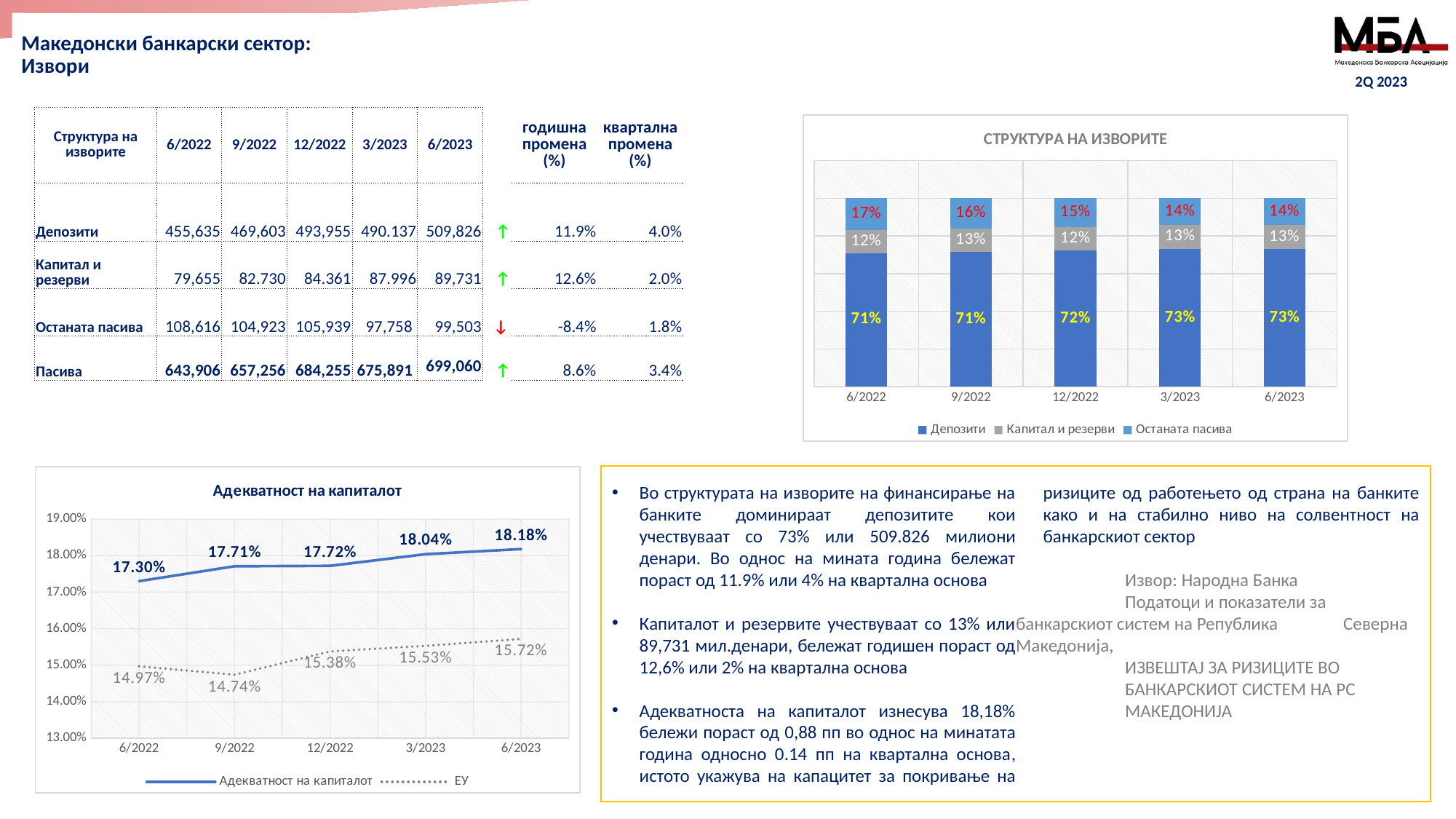
How many periods are shown on the x axis of the 'СТРУКТУРА НА ИЗВОРИТЕ' chart? 5 In the 'Адекватност на капиталот' chart, what is the value of Адекватност на капиталот in 6/2023? 18.18% In the 'Адекватност на капиталот' chart, which series has the larger value in 12/2022, Адекватност на капиталот or ЕУ? Адекватност на капиталот In the 'СТРУКТУРА НА ИЗВОРИТЕ' chart, what share does Останата пасива have in 6/2022? 17% In the 'Адекватност на капиталот' chart, what is the ЕУ value in 9/2022? 14.74% In the 'СТРУКТУРА НА ИЗВОРИТЕ' chart, what share do Депозити have in 6/2023? 73% What kind of chart is 'СТРУКТУРА НА ИЗВОРИТЕ'? stacked bar chart In the 'Адекватност на капиталот' chart, in which period is the ЕУ value lowest? 9/2022 How many series does the legend of the 'СТРУКТУРА НА ИЗВОРИТЕ' chart list? 3 In the 'СТРУКТУРА НА ИЗВОРИТЕ' chart, does the share of Останата пасива rise or fall from 6/2022 to 6/2023? fall In the 'Адекватност на капиталот' chart, what is the difference between Адекватност на капиталот and ЕУ in 6/2023? 2.46 percentage points In the 'Адекватност на капиталот' chart, in which period is Адекватност на капиталот highest? 6/2023